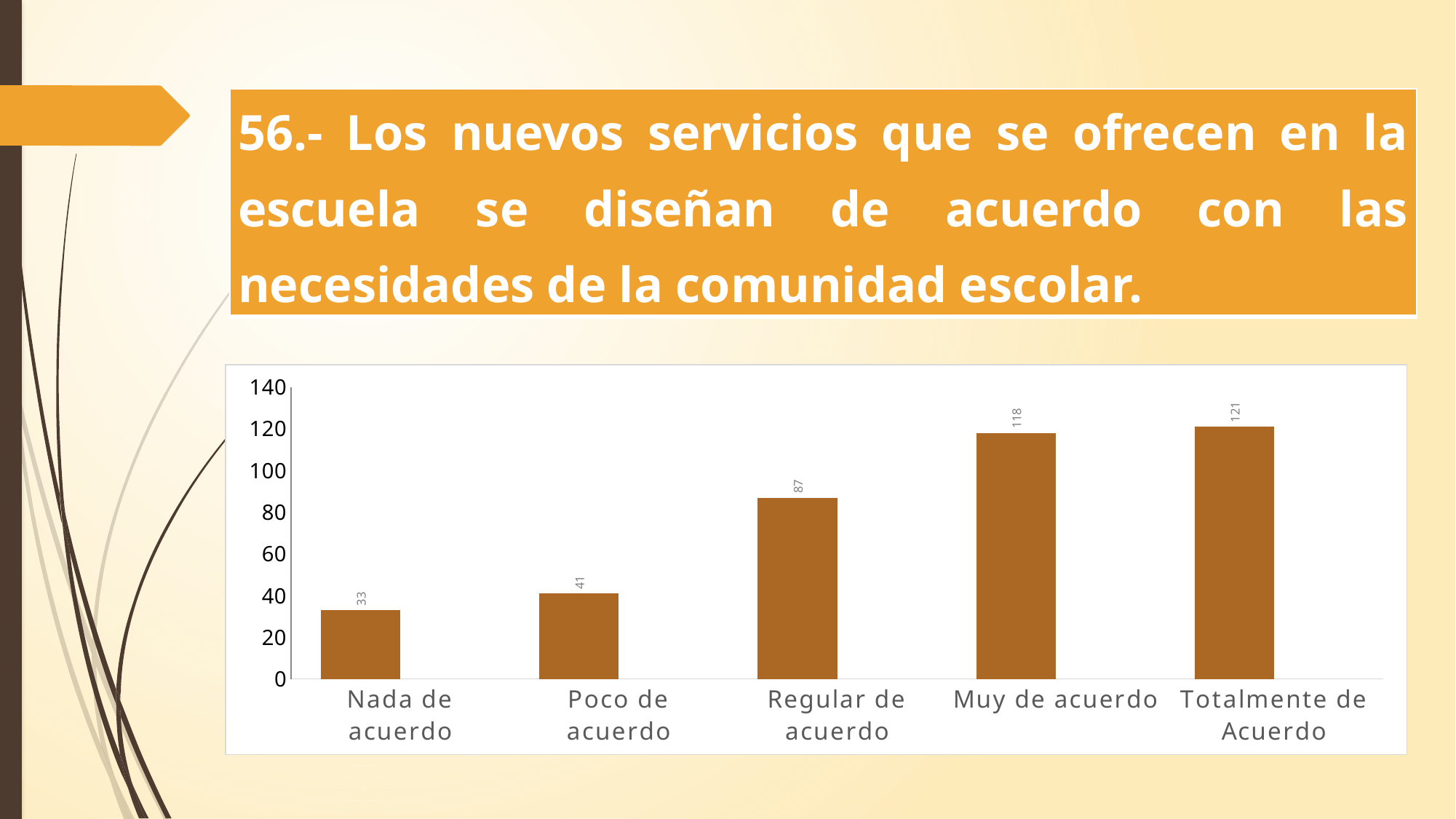
What is the value for "Nada de acuerdo"? 33 Which category has the highest value? Totalmente de Acuerdo What is the value for "Totalmente de Acuerdo"? 121 What is the value for "Poco de acuerdo"? 41 What kind of chart is shown on the slide? Bar chart What is the value for "Regular de acuerdo"? 87 How many categories are shown on the x axis? 5 What is the value for "Muy de acuerdo"? 118 Which category has the lowest value? Nada de acuerdo What is the difference between the values for "Muy de acuerdo" and "Regular de acuerdo"? 31 Which is larger, the value for "Poco de acuerdo" or the value for "Regular de acuerdo"? Regular de acuerdo Do the values rise or fall from left to right along the x axis? Rise